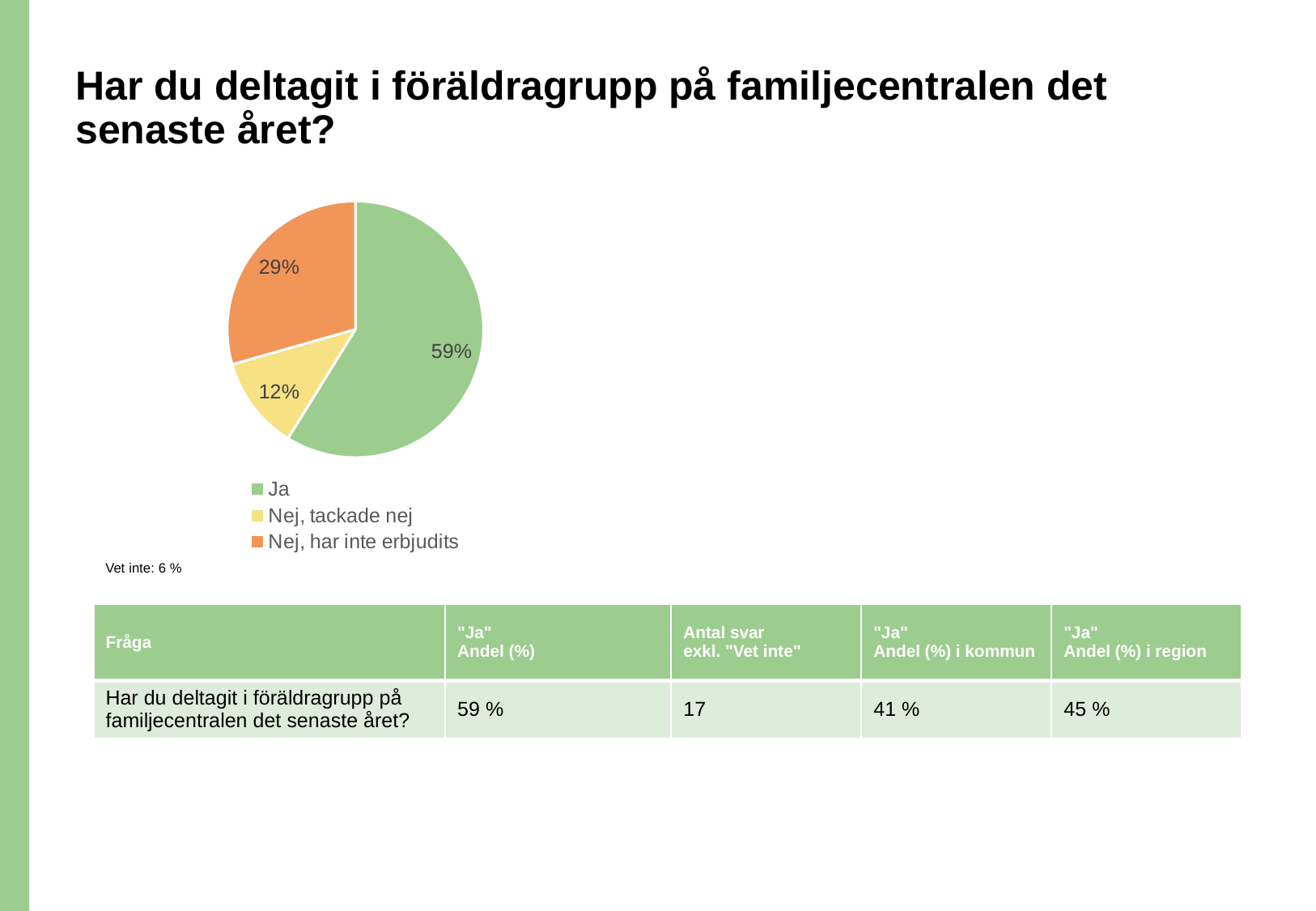
Which legend entry is shown in orange? Nej, har inte erbjudits What is the value for "Nej, har inte erbjudits"? 29% What share of the pie does "Ja" represent? 59% Which is larger, "Nej, har inte erbjudits" or "Nej, tackade nej"? Nej, har inte erbjudits Which category has the largest slice of the pie? Ja What is the difference between the "Ja" slice and the "Nej, har inte erbjudits" slice? 30% What kind of chart is shown on the slide? Pie chart How many categories does the pie chart show? 3 What is the value for "Nej, tackade nej"? 12% What colour is the "Ja" slice in the pie chart? Green Which category has the smallest slice of the pie? Nej, tackade nej What is the combined share of the two "Nej" slices? 41%